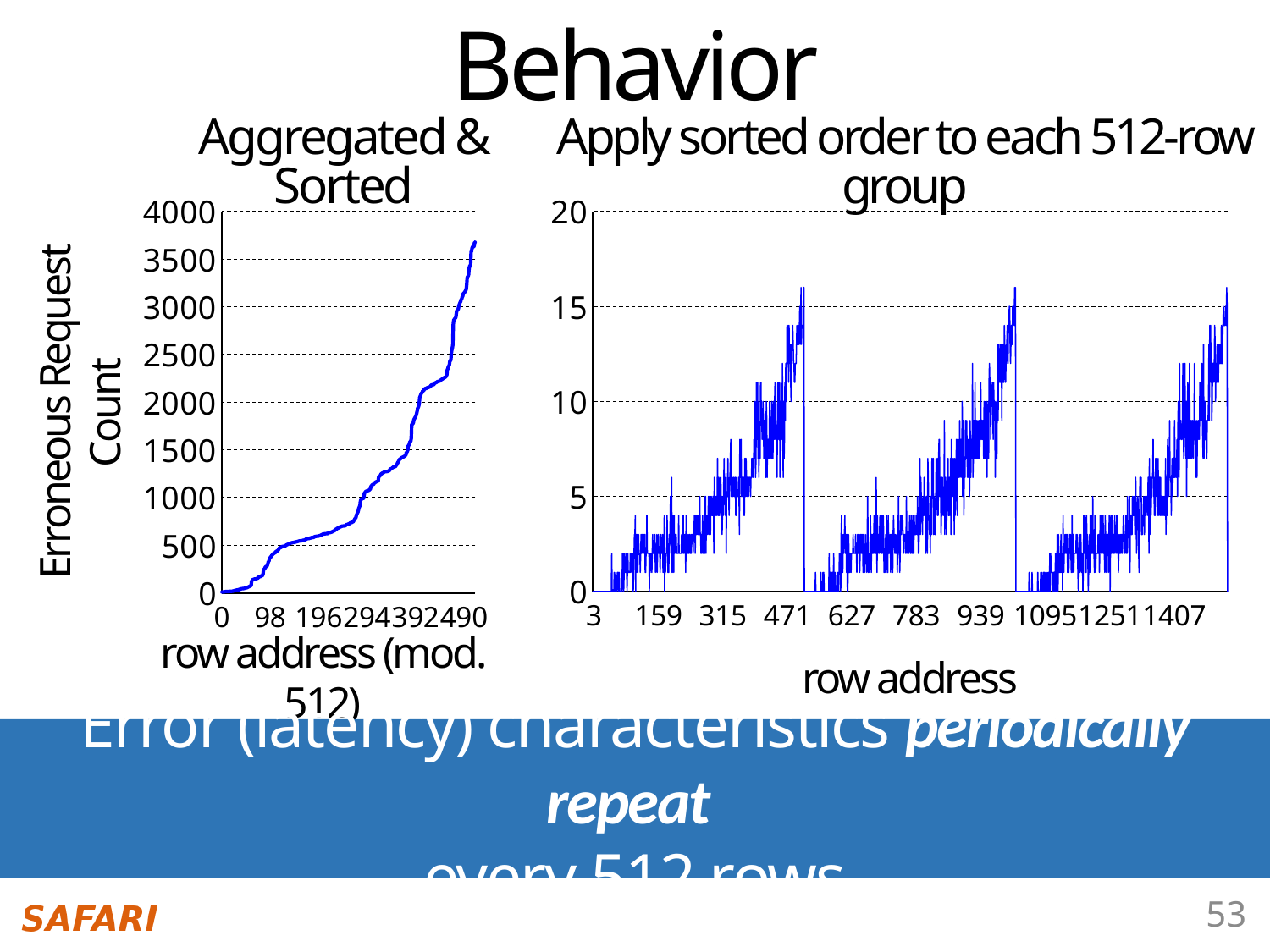
What is the x-axis label of the chart on the right? row address In the chart on the right, how many repeating 512-row groups are plotted? 3 What is the highest tick value on the y-axis of the chart on the right? 20 What is the y-axis label of the "Aggregated & Sorted" chart? Erroneous Request Count In the chart on the right, is the value at row address 159 greater or less than 5? less In the chart on the right, is the value at row address 1095 greater or less than 5? less In the "Aggregated & Sorted" chart, do the values rise or fall as the row address increases? rise In the "Aggregated & Sorted" chart, is the value at row address 490 greater or less than 3000? greater What kind of chart is the "Aggregated & Sorted" chart on the left? line chart